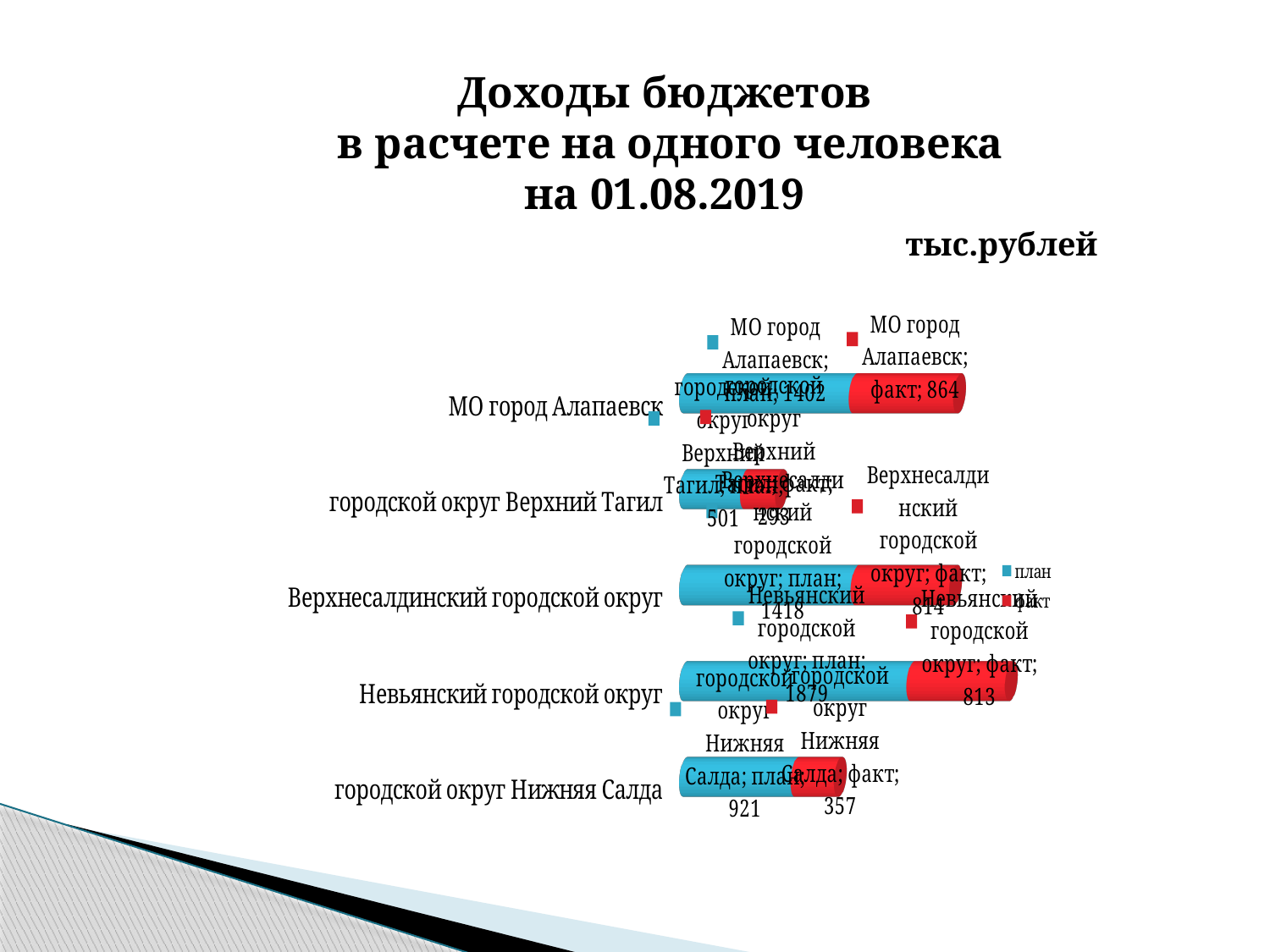
How many series does the legend list? 2 How many categories (municipalities) are shown on the chart? 5 What is the difference between the план and факт values for МО город Алапаевск? 538 What kind of chart is shown on the slide? bar chart What is the факт value for МО город Алапаевск? 864 What is the план value for городской округ Верхний Тагил? 501 Which category has the highest план value? Невьянский городской округ What is the факт value for Верхнесалдинский городской округ? 814 What is the план value for Невьянский городской округ? 1879 Which category has the lowest план value? городской округ Верхний Тагил Which is larger, the план value for Верхнесалдинский городской округ or the план value for МО город Алапаевск? Верхнесалдинский городской округ What is the план value for городской округ Нижняя Салда? 921